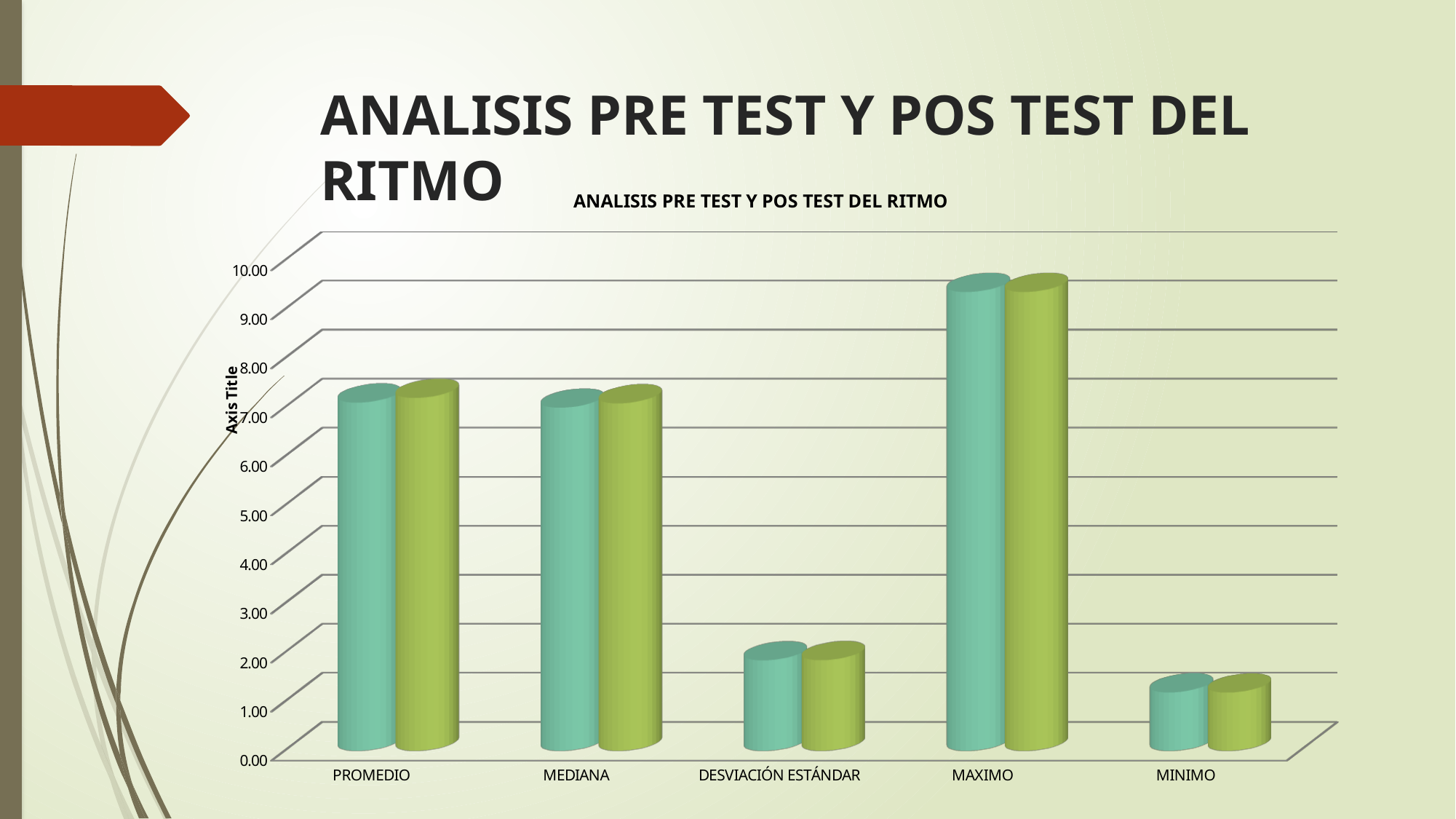
Which category has the lowest bars in the chart? MINIMO Are the bars for DESVIACIÓN ESTÁNDAR greater or less than 3.00? less Are the bars for PROMEDIO greater or less than 6.00? greater How many categories are shown on the x axis of the chart? 5 What is the title of the chart? ANALISIS PRE TEST Y POS TEST DEL RITMO Which category has larger values, DESVIACIÓN ESTÁNDAR or MINIMO? DESVIACIÓN ESTÁNDAR What is the label shown on the vertical axis of the chart? Axis Title Are the bars for MAXIMO greater or less than 8.00? greater What kind of chart is shown on the slide? Bar chart Which category has the highest bars in the chart? MAXIMO Which category has larger values, MAXIMO or PROMEDIO? MAXIMO